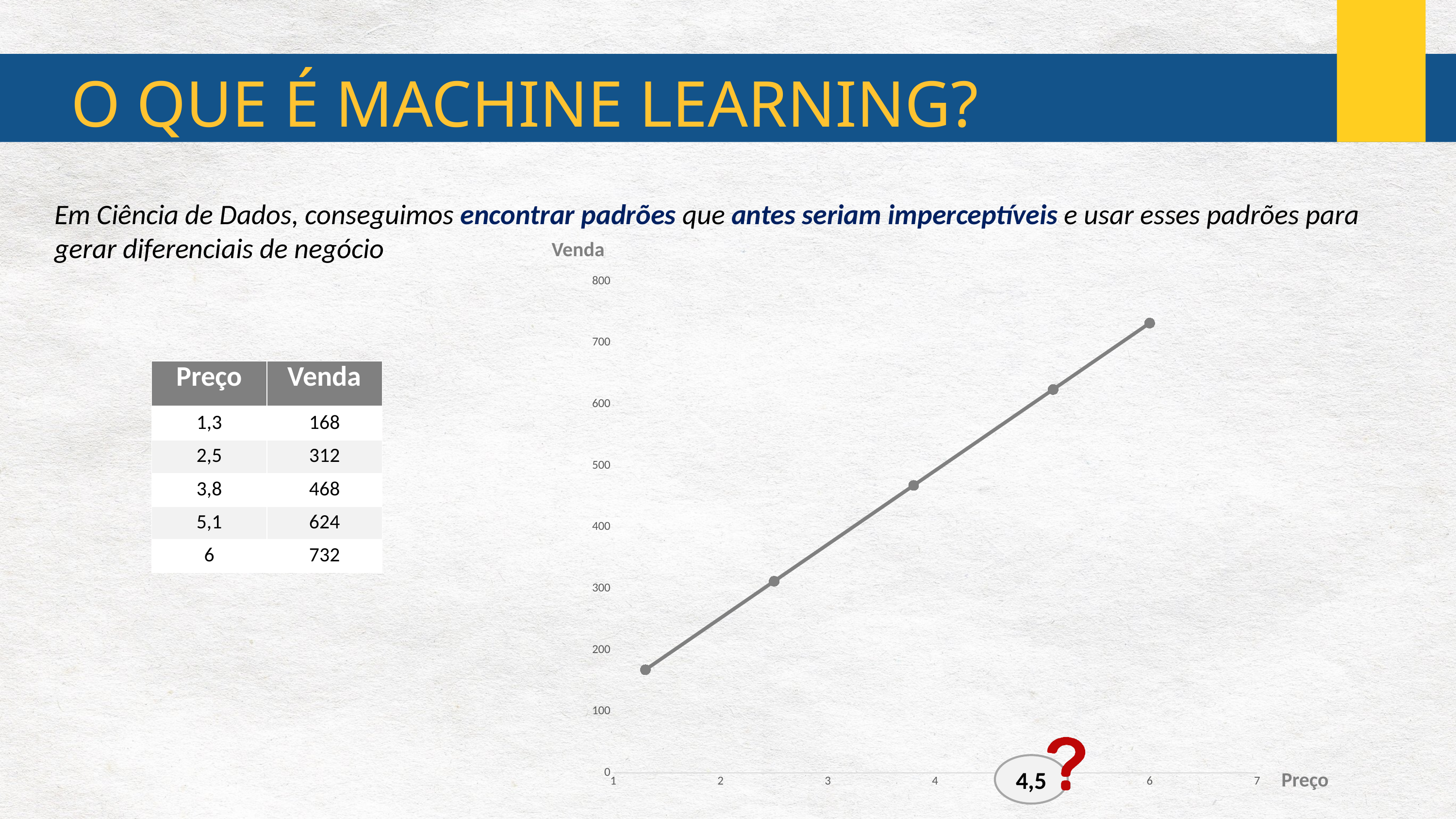
At which Preço value is Venda lowest? 1,3 What is the title of the vertical axis of the chart? Venda How many data points are plotted on the chart? 5 Do the Venda values rise or fall as Preço increases along the x axis? rise What is the difference between the Venda at Preço 6 and the Venda at Preço 1,3? 564 What is the Venda value at Preço 3,8? 468 At which Preço value is Venda highest? 6 Is the Venda value at Preço 3,8 greater or less than 400? greater What is the Venda value at Preço 6? 732 What is the title of the horizontal axis of the chart? Preço What kind of chart is shown on the slide? line chart Which has a larger Venda value: Preço 5,1 or Preço 2,5? 5,1